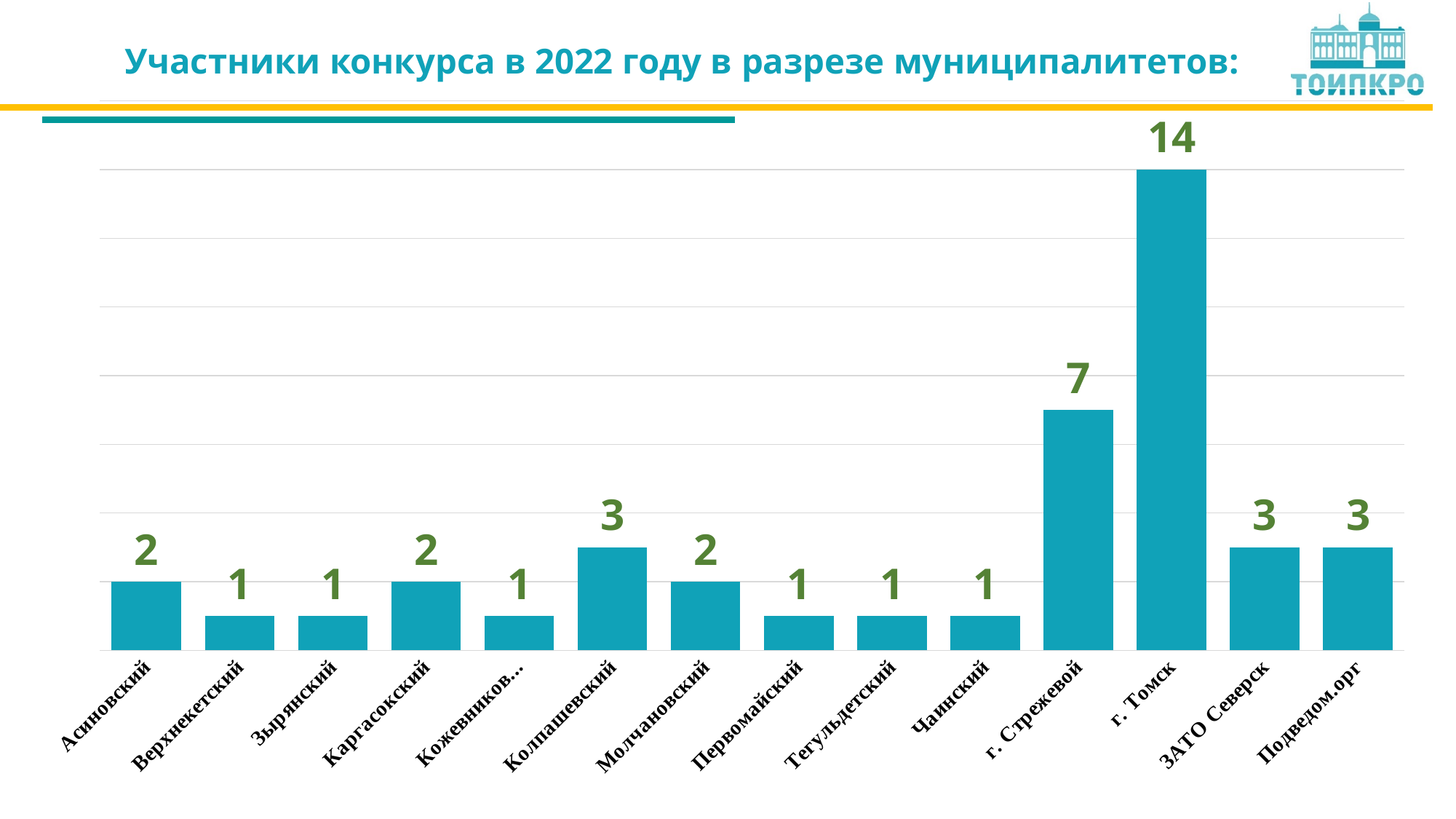
What is the value for г. Томск? 14 What is the difference between the values for ЗАТО Северск and Молчановский? 1 What is the value for Чаинский? 1 What is the difference between the values for г. Томск and г. Стрежевой? 7 How many categories are shown on the x axis? 14 What is the value for Колпашевский? 3 What is the title of the chart on the slide? Участники конкурса в 2022 году в разрезе муниципалитетов: What is the value for г. Стрежевой? 7 Which category has the highest value? г. Томск What kind of chart is shown on the slide? Bar chart What is the value for Асиновский? 2 Which is larger, the value for Каргасокский or the value for Колпашевский? Колпашевский